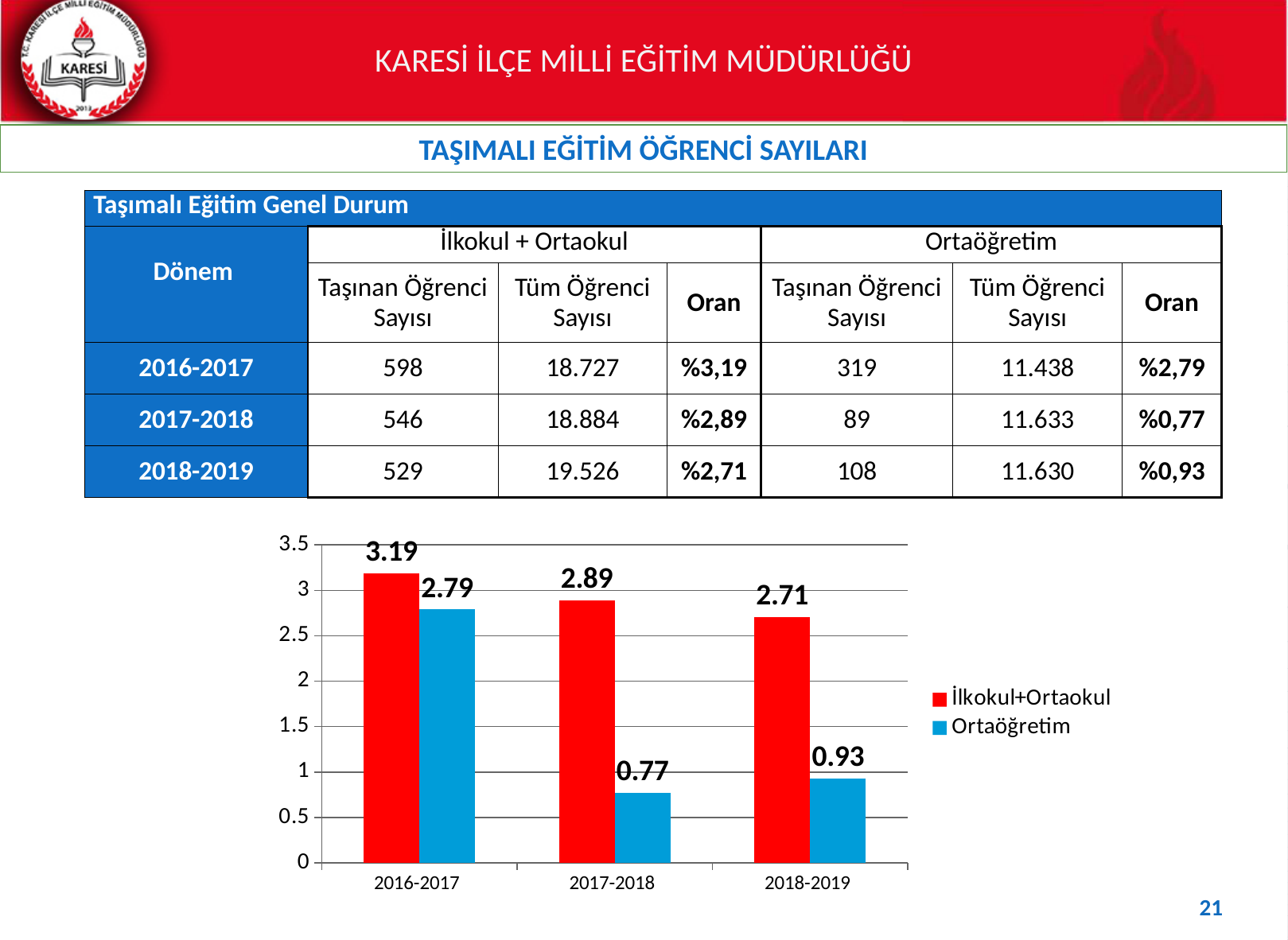
What is the value for Ortaöğretim in 2017-2018? 0.77 What is the value for İlkokul+Ortaokul in 2016-2017? 3.19 How many series does the chart legend list? 2 How many periods are shown on the x axis of the chart? 3 Do the İlkokul+Ortaokul values rise or fall from 2016-2017 to 2018-2019? Fall What kind of chart is shown on the slide? Bar chart Which period has the lowest value for Ortaöğretim? 2017-2018 Which is larger in 2016-2017: İlkokul+Ortaokul or Ortaöğretim? İlkokul+Ortaokul Is the value for Ortaöğretim in 2016-2017 greater or less than 2.5? greater Which period has the highest value for İlkokul+Ortaokul? 2016-2017 What is the value for Ortaöğretim in 2018-2019? 0.93 What is the difference between the İlkokul+Ortaokul and Ortaöğretim values in 2017-2018? 2.12